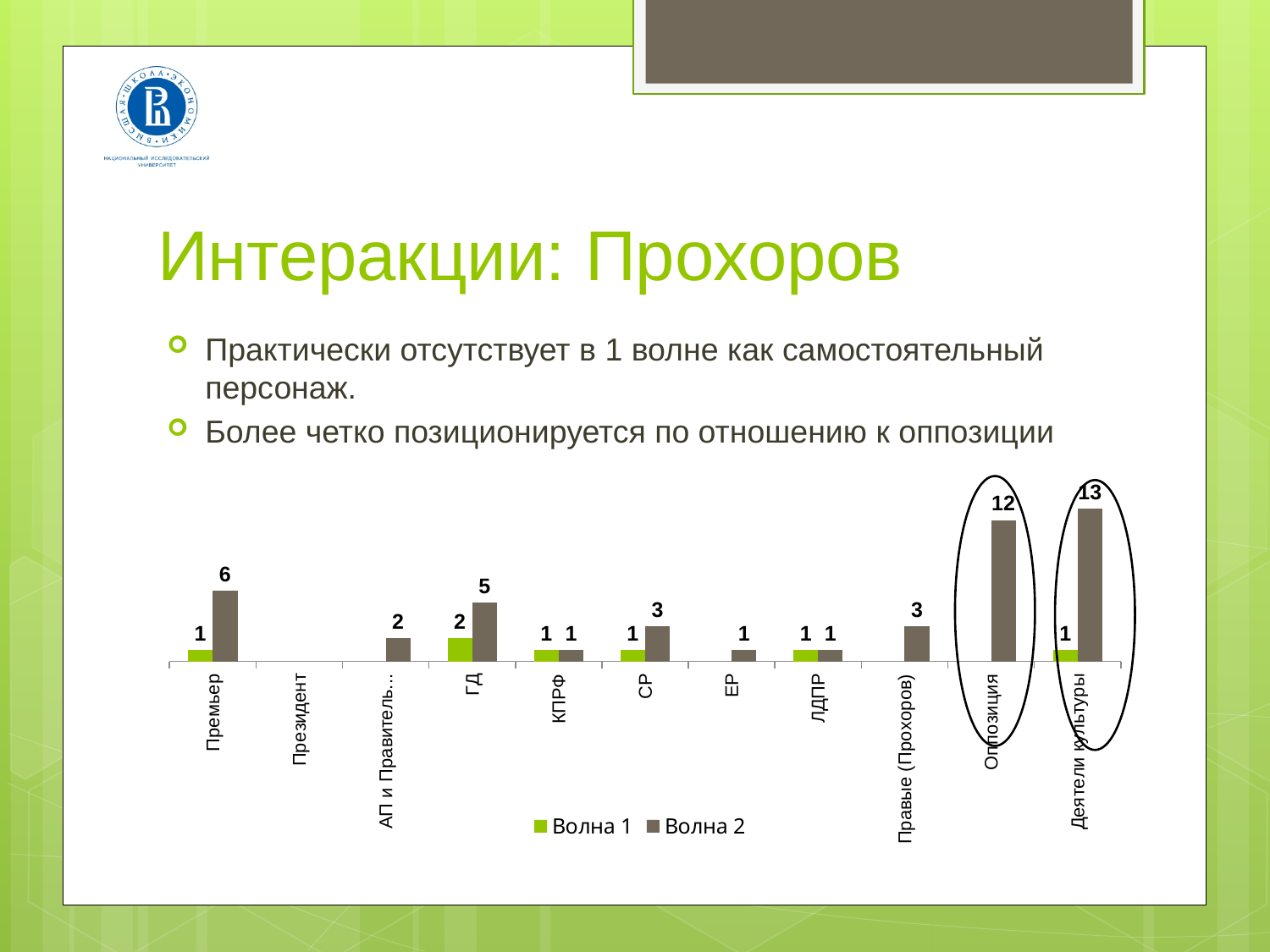
How many categories are shown on the x axis of the chart? 11 What is the Волна 2 value for Премьер? 6 What is the Волна 2 value for Оппозиция? 12 Which category has the highest Волна 2 value? Деятели культуры What is the difference between the Волна 2 and Волна 1 values for Премьер? 5 What kind of chart is shown on the slide? Bar chart What is the Волна 1 value for ГД? 2 What are the two series names listed in the chart legend? Волна 1 and Волна 2 How many series does the chart legend list? 2 Which is larger: the Волна 2 value for ГД or the Волна 2 value for СР? ГД What is the Волна 2 value for Деятели культуры? 13 What is the difference between the Волна 2 values for Деятели культуры and Оппозиция? 1